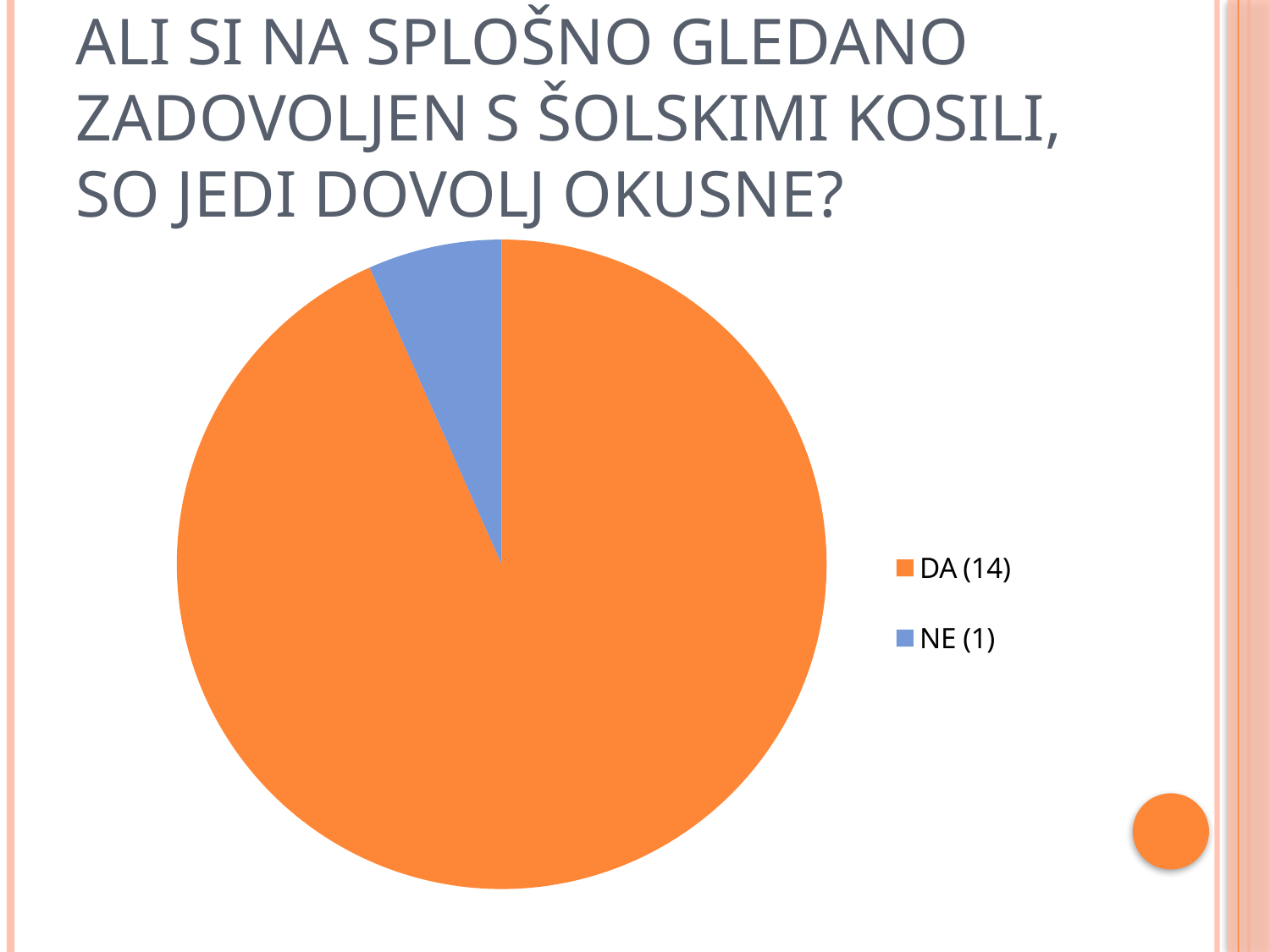
Which is larger, the number of DA answers or the number of NE answers? DA Which answer has the smallest slice of the pie? NE Which answer has the largest slice of the pie? DA What kind of chart is shown on the slide? pie chart What is the difference between the number of DA answers and NE answers? 13 What is the total number of responses shown in the pie chart? 15 What colour is the NE slice of the pie chart? blue How many respondents answered DA? 14 How many slices does the pie chart have? 2 What colour is the DA slice of the pie chart? orange How many entries does the legend list? 2 How many respondents answered NE? 1